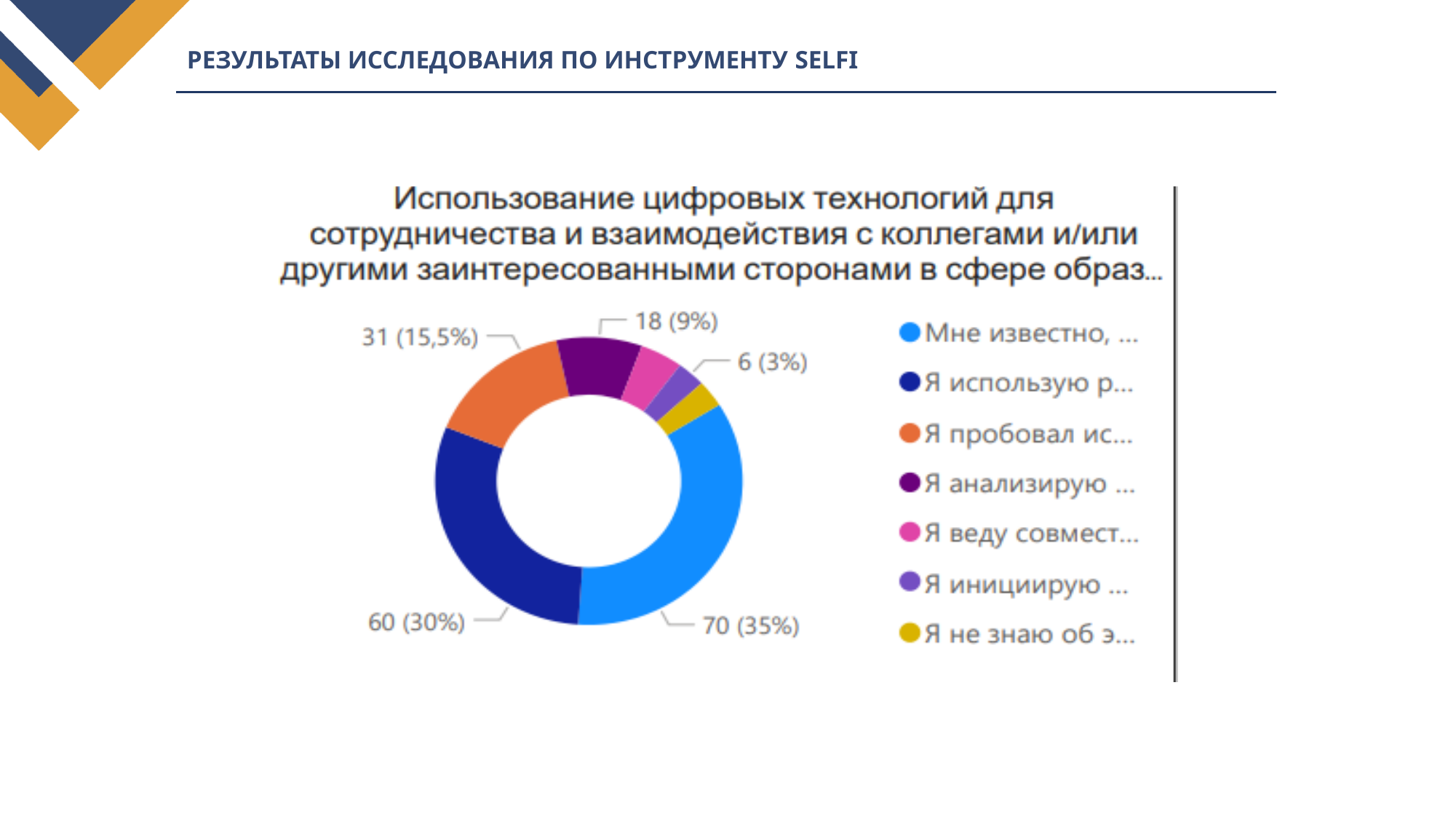
Which slice is larger: "Я использую р..." or "Я пробовал ис..."? Я использую р... What value is shown for the slice labelled "Мне известно, ..."? 70 (35%) What value is shown for the slice labelled "Я использую р..."? 60 (30%) What value is shown for the slice labelled "Я пробовал ис..."? 31 (15,5%) What colour is the slice for "Я пробовал ис..."? Orange What kind of chart is shown on the slide? Pie (donut) chart What value is shown for the slice labelled "Я анализирую ..."? 18 (9%) What share of the chart does the "Я пробовал ис..." slice represent? 15,5% How many entries does the chart's legend list? 7 Which legend category has the largest slice of the chart? Мне известно, ... What is the difference in count between the "Мне известно, ..." slice and the "Я использую р..." slice? 10